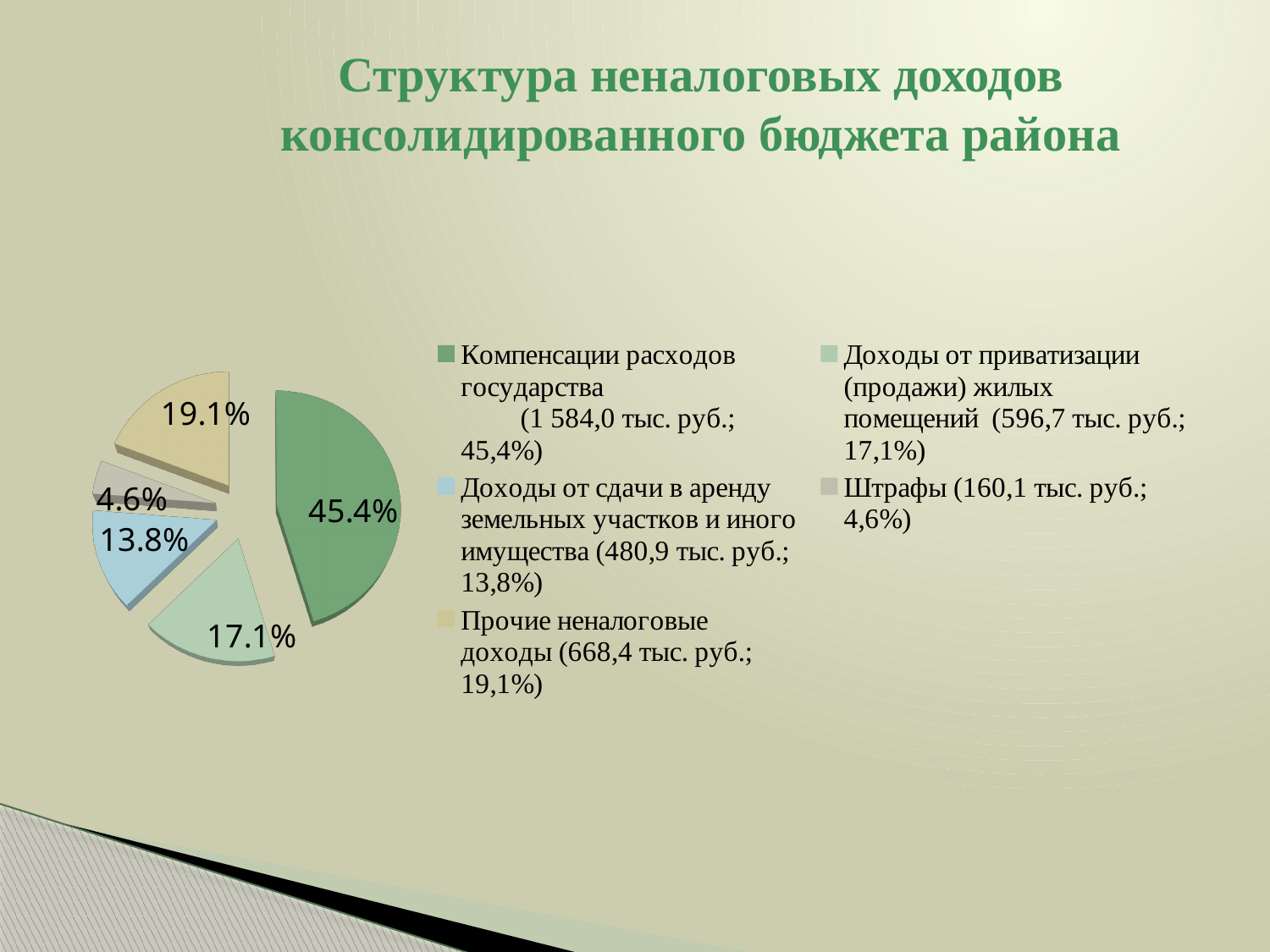
Which is larger: the share for "Доходы от приватизации (продажи) жилых помещений" or the share for "Доходы от сдачи в аренду земельных участков и иного имущества"? Доходы от приватизации (продажи) жилых помещений How many slices does the pie chart have? 5 What share of the pie does "Компенсации расходов государства" take? 45.4% According to the legend, what is the amount in thousand rubles for "Доходы от приватизации (продажи) жилых помещений"? 596,7 тыс. руб. How many entries does the legend of the pie chart list? 5 Which category has the smallest slice of the pie? Штрафы According to the legend, what is the amount in thousand rubles for "Доходы от сдачи в аренду земельных участков и иного имущества"? 480,9 тыс. руб. What is the difference in percentage points between the largest slice (45.4%) and the "Прочие неналоговые доходы" slice (19.1%)? 26.3 What kind of chart is shown on the slide? pie chart What share of the pie does "Штрафы" take? 4.6% What share of the pie does "Прочие неналоговые доходы" take? 19.1% Which category has the largest slice of the pie? Компенсации расходов государства